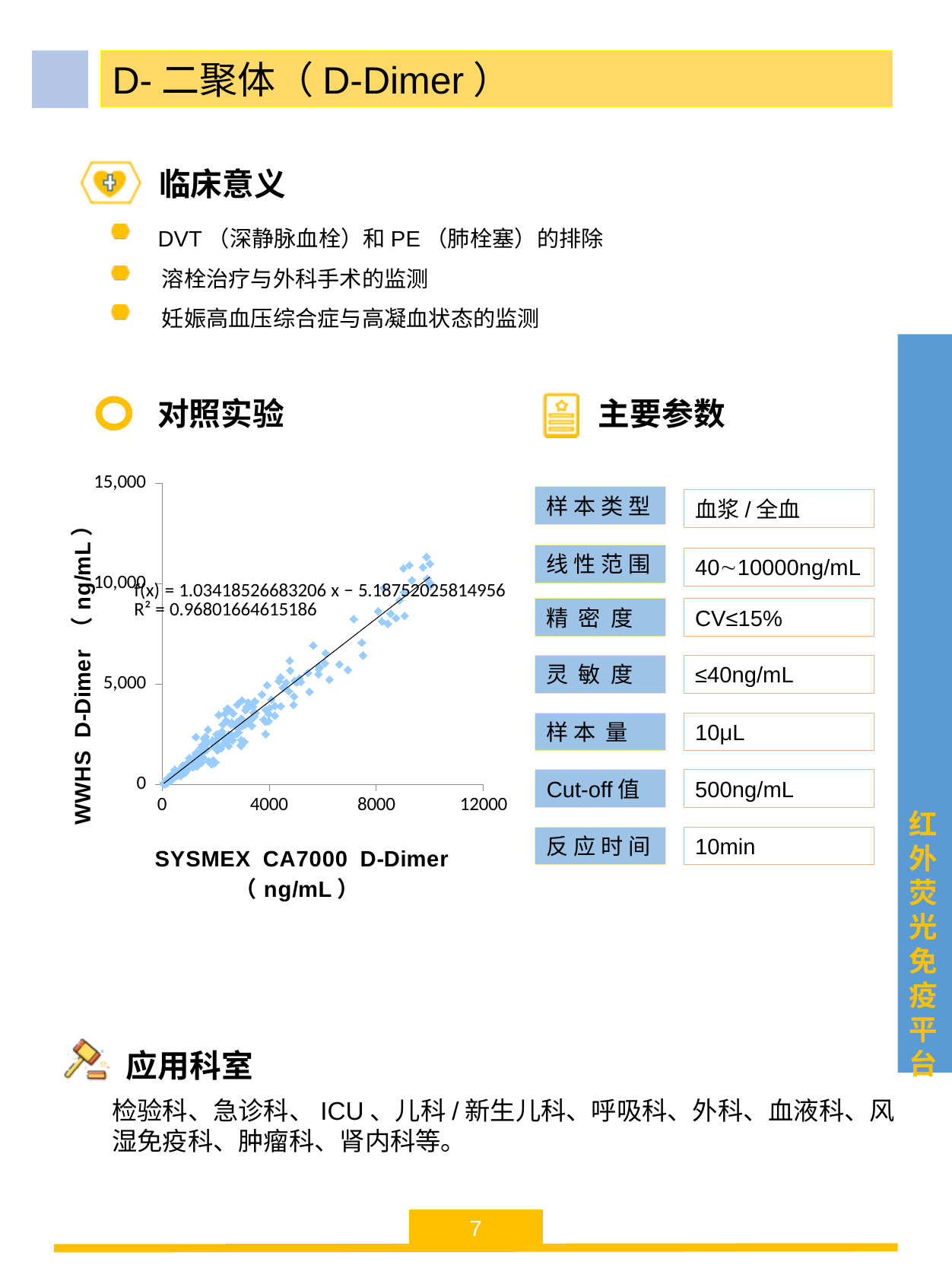
Do the WWHS D-Dimer values rise or fall as the SYSMEX CA7000 D-Dimer values increase along the x axis? rise What is the slope of the trendline equation printed on the scatter chart? 1.03418526683206 What is the highest tick value shown on the y axis of the scatter chart? 15,000 Is the largest SYSMEX CA7000 D-Dimer value plotted on the scatter chart greater or less than 12000? less What is the label of the y axis of the scatter chart? WWHS D-Dimer (ng/mL) What is the R² value printed on the scatter chart? 0.96801664615186 Is the highest WWHS D-Dimer value plotted on the scatter chart greater or less than 15,000? less What is the intercept in the trendline equation f(x) printed on the scatter chart? −5.18752025814956 Is the highest WWHS D-Dimer value plotted on the scatter chart greater or less than 10,000? greater What is the highest tick value shown on the x axis of the scatter chart? 12000 What kind of chart is shown under 对照实验? scatter chart What is the label of the x axis of the scatter chart? SYSMEX CA7000 D-Dimer (ng/mL)